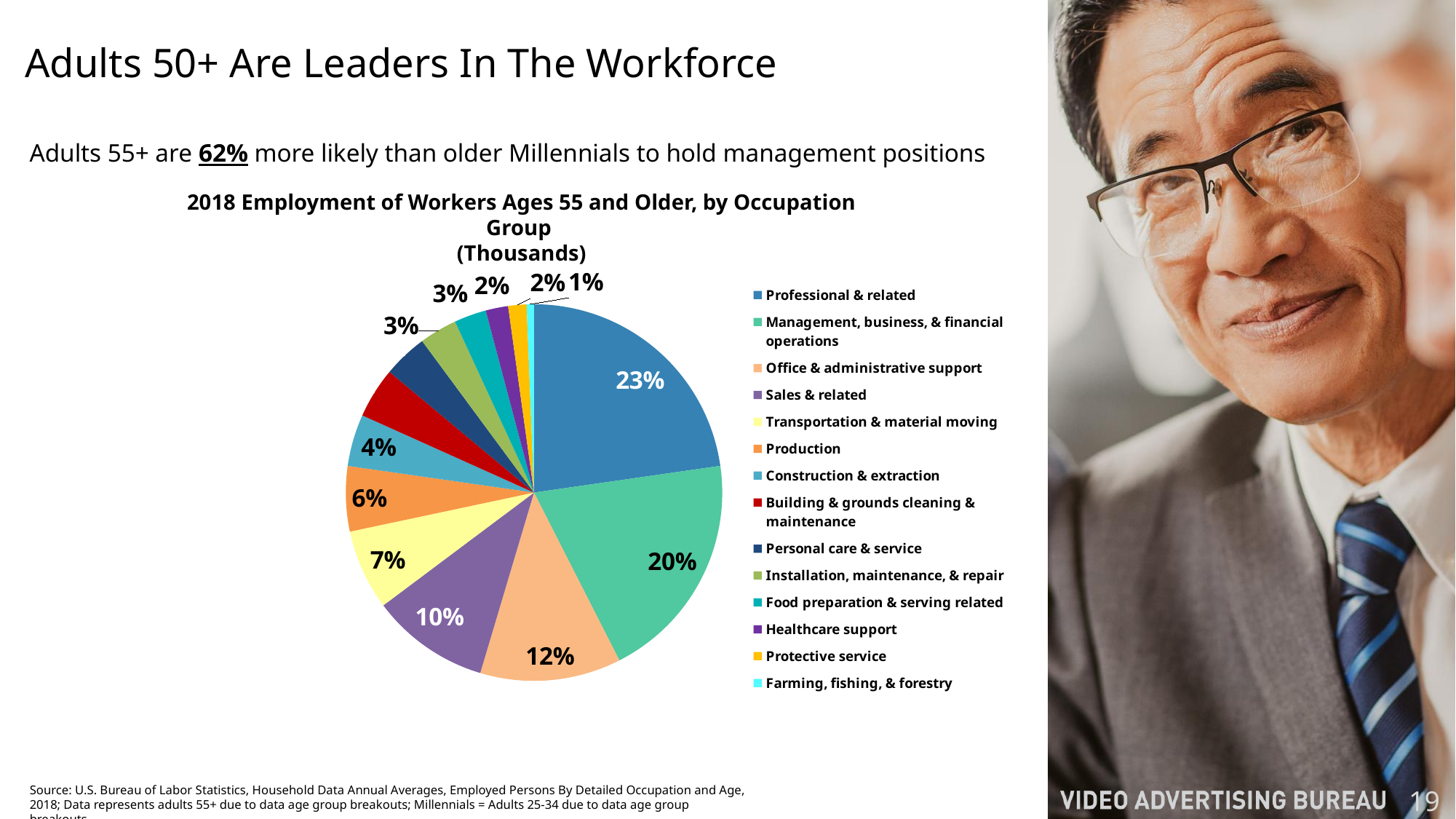
What percentage is shown for Production? 6% Which occupation group has the smallest slice of the pie? Farming, fishing, & forestry What is the value for Office & administrative support? 12% Which is larger, Sales & related or Transportation & material moving? Sales & related What is the difference in percentage points between Professional & related and Management, business, & financial operations? 3 percentage points What is the title of the pie chart? 2018 Employment of Workers Ages 55 and Older, by Occupation Group (Thousands) What share of the pie does Professional & related hold? 23% What percentage is shown for Management, business, & financial operations? 20% What kind of chart is shown on the slide? Pie chart How many occupation groups are listed in the legend? 14 Which occupation group has the largest slice of the pie? Professional & related What is the value for Farming, fishing, & forestry? 1%